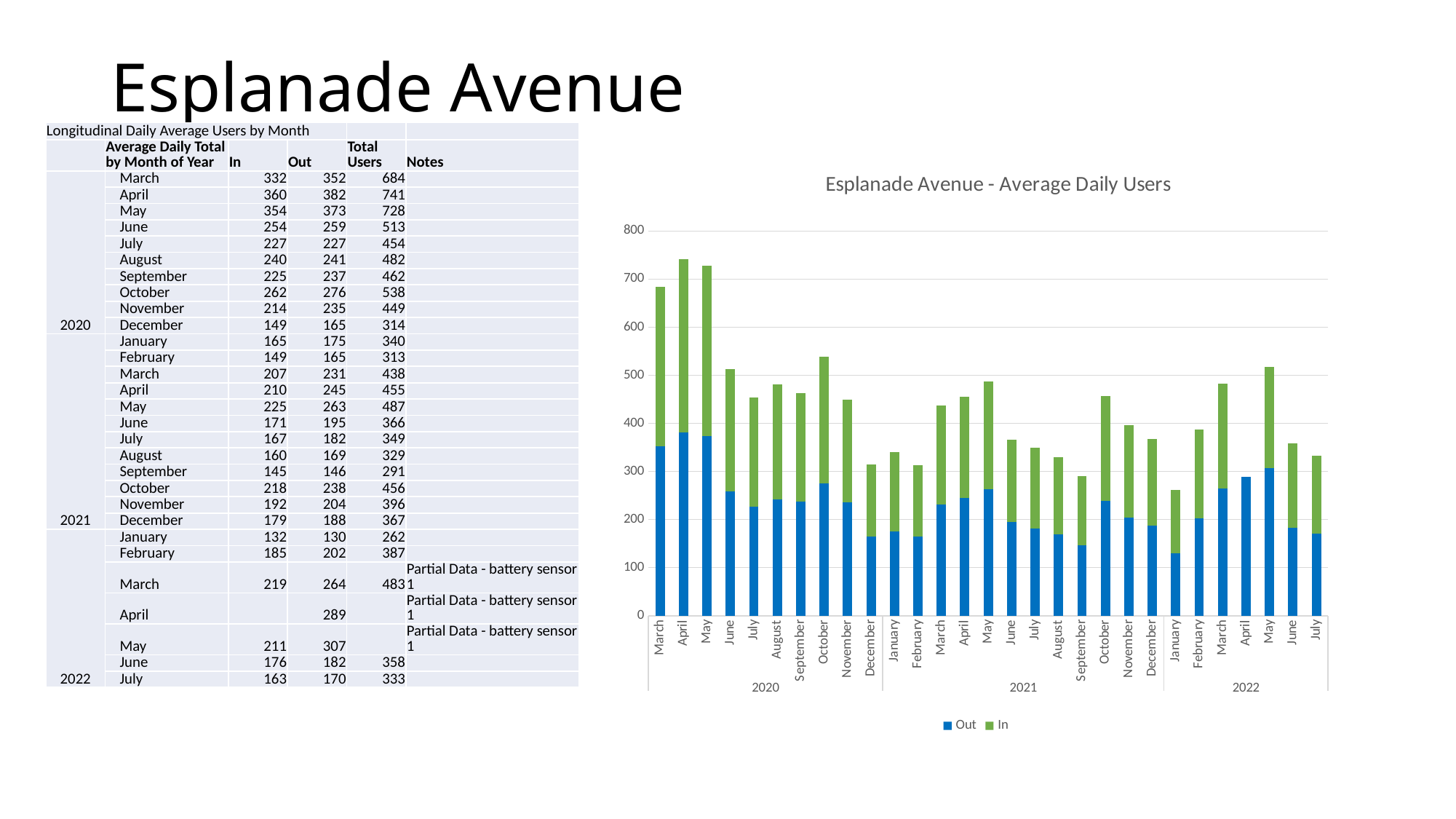
Is the total bar for October 2020 in the 'Esplanade Avenue - Average Daily Users' chart greater or less than 500? greater Using the table values, what is the difference between the total users for March 2020 and December 2020? 370 Which series in the 'Esplanade Avenue - Average Daily Users' chart is shown in green? In How many series does the legend of the 'Esplanade Avenue - Average Daily Users' chart list? 2 In the 'Esplanade Avenue - Average Daily Users' chart, which month has the highest total bar? April 2020 In the 'Esplanade Avenue - Average Daily Users' chart, which month has the lowest total bar? January 2022 According to the table, what is the 'Out' value for October 2021? 238 How many monthly bars are plotted in the 'Esplanade Avenue - Average Daily Users' chart? 29 According to the table, what is the total users value for April 2020? 741 In the 'Esplanade Avenue - Average Daily Users' chart, is the total bar for May 2022 larger or smaller than the total bar for June 2022? larger What kind of chart is 'Esplanade Avenue - Average Daily Users'? Stacked bar chart